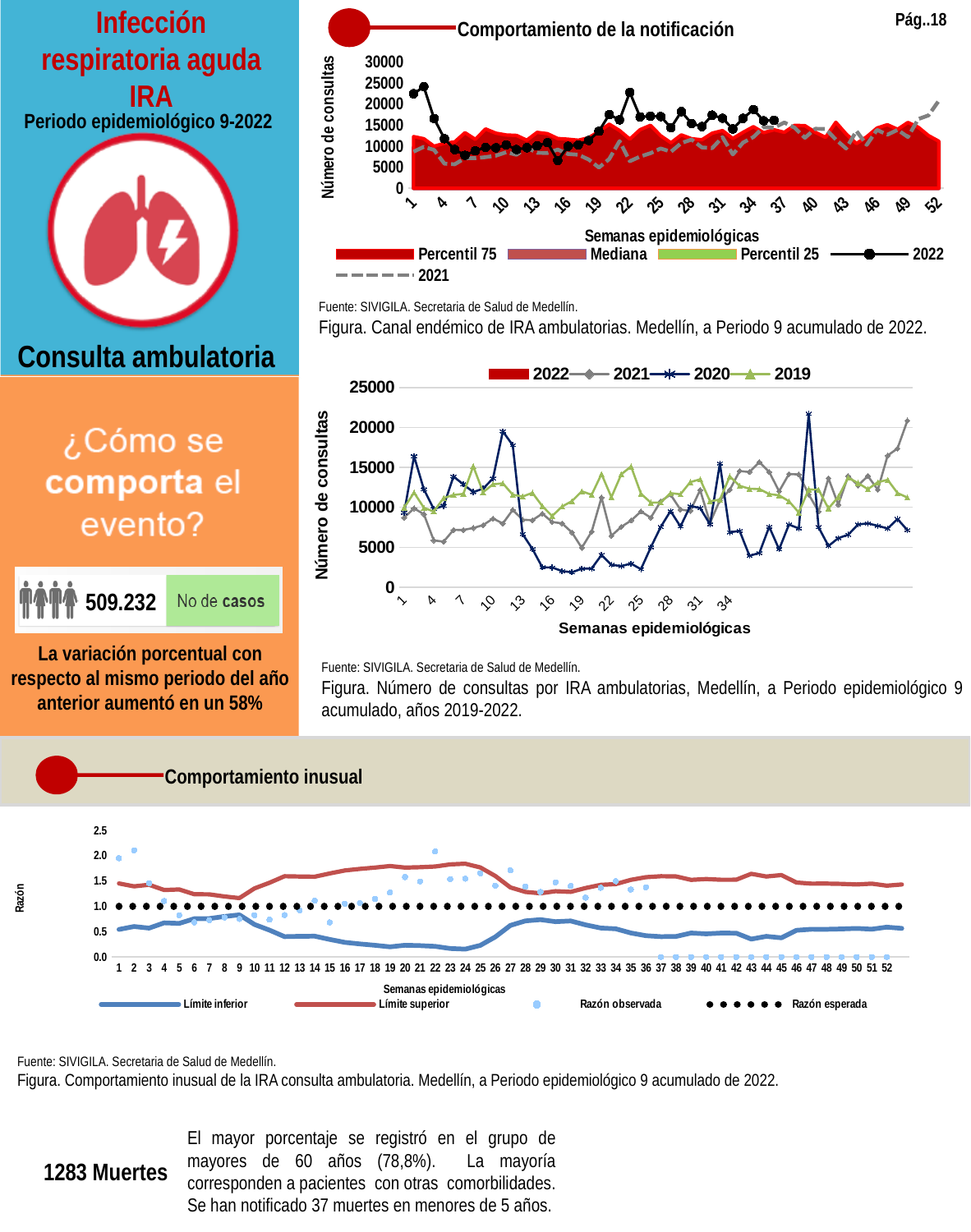
In the bottom chart 'Comportamiento inusual', does the Límite inferior series rise or fall between week 9 and week 16? fall In the bottom chart 'Comportamiento inusual', what is the value of the Razón esperada series? 1.0 In the bottom chart 'Comportamiento inusual', how many epidemiological weeks are shown on the x axis? 52 In the top chart 'Comportamiento de la notificación', what is the label of the x axis? Semanas epidemiológicas In the middle chart 'Número de consultas por IRA ambulatorias', how many series does the legend list? 4 In the top chart 'Comportamiento de la notificación', is the 2022 value at week 2 greater or less than 20000? greater In the middle chart 'Número de consultas por IRA ambulatorias', does the 2020 series rise or fall between week 12 and week 16? fall In the middle chart 'Número de consultas por IRA ambulatorias', what kind of chart is it? line chart In the middle chart 'Número de consultas por IRA ambulatorias', which series reaches the highest peak, 2020 or 2019? 2020 In the middle chart 'Número de consultas por IRA ambulatorias', is the 2020 value at week 16 greater or less than 5000? less In the top chart 'Comportamiento de la notificación', how many series does the legend list? 5